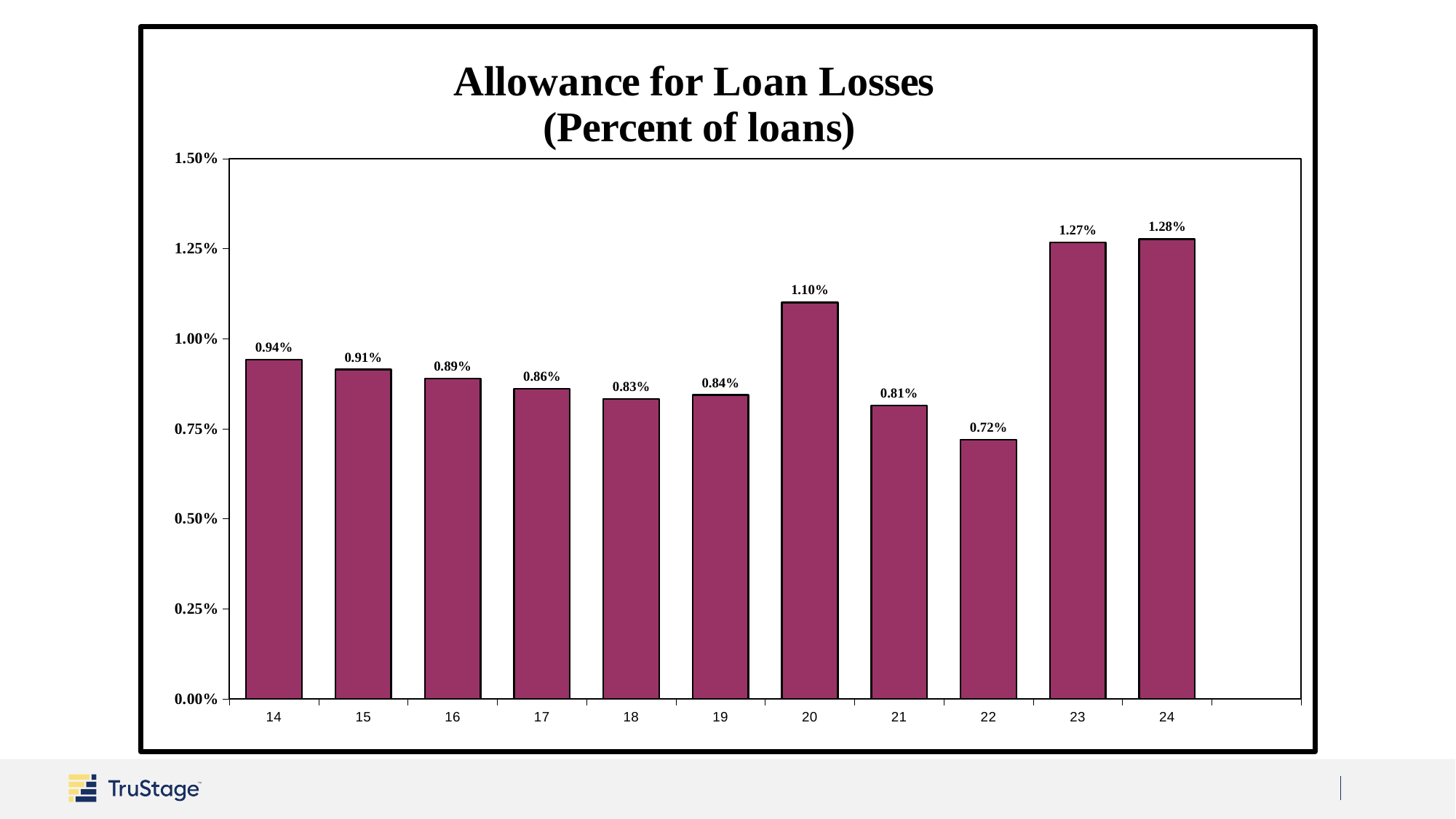
Do the values rise or fall from 14 to 18? fall Which is larger, the value for 20 or the value for 21? 20 What is the allowance for loan losses value for 20? 1.10% What is the value shown for 22? 0.72% What is the title of the chart? Allowance for Loan Losses (Percent of loans) Is the value for 23 greater or less than 1.00%? greater What is the difference between the values for 24 and 22? 0.56% Which year has the lowest allowance for loan losses? 22 What is the value shown for 14? 0.94% Which year has the highest allowance for loan losses? 24 How many years are shown on the x axis? 11 What kind of chart is shown on the slide? bar chart